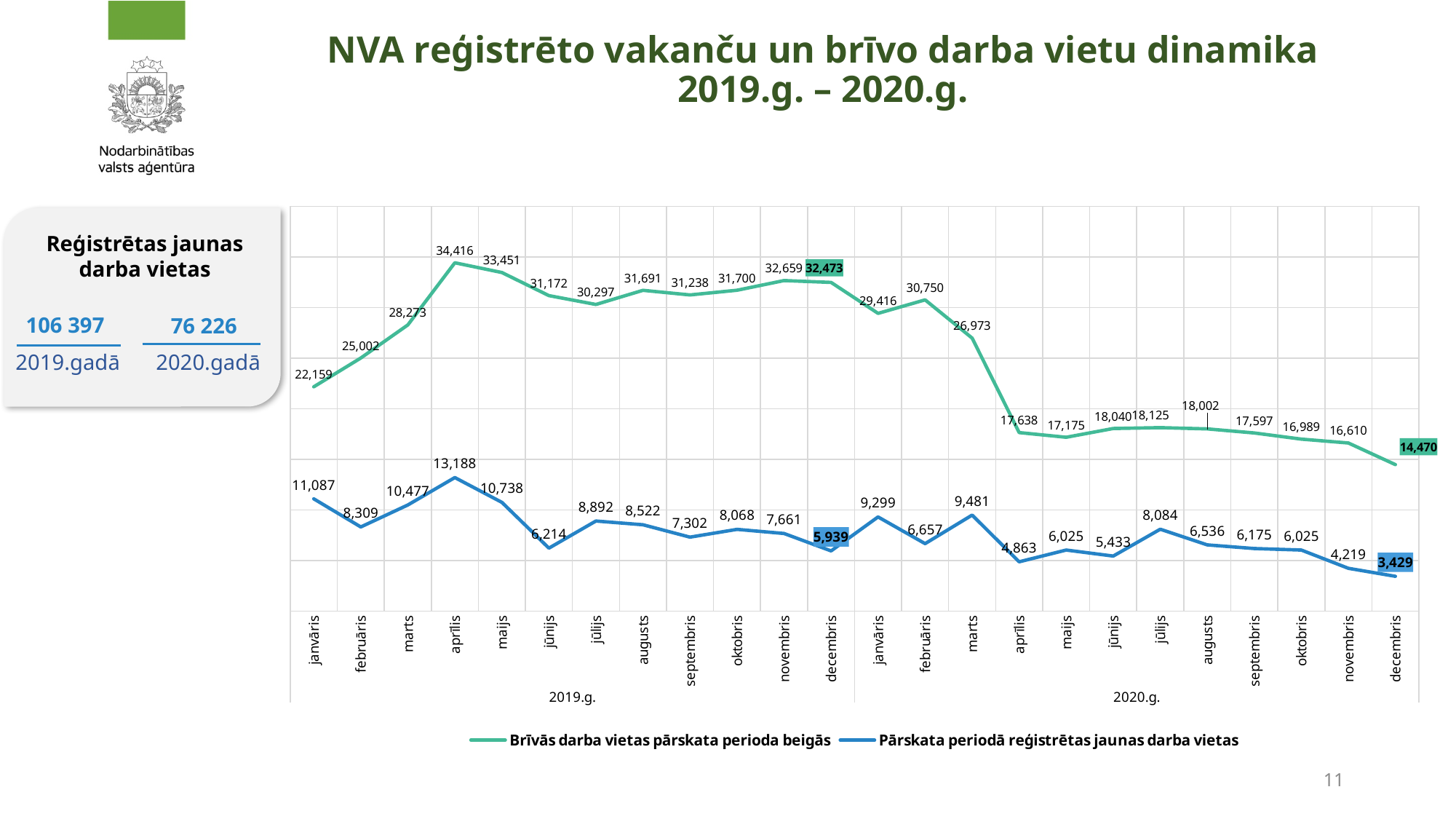
What type of chart is shown on the slide? Line chart Does 'Brīvās darba vietas pārskata perioda beigās' rise or fall from marts 2020 to decembris 2020? Fall What is the value of 'Brīvās darba vietas pārskata perioda beigās' for aprīlis 2019? 34,416 What is the value of 'Pārskata periodā reģistrētas jaunas darba vietas' for decembris 2020? 3,429 How many months are plotted on the x axis in total? 24 In which month and year does 'Brīvās darba vietas pārskata perioda beigās' reach its highest value? aprīlis 2019 What is the difference between the two series in aprīlis 2019? 21,228 Which is larger: 'Pārskata periodā reģistrētas jaunas darba vietas' in marts 2020 or in jūlijs 2020? marts 2020 What is the difference between 'Brīvās darba vietas pārskata perioda beigās' in decembris 2019 and decembris 2020? 18,003 What is the value of 'Brīvās darba vietas pārskata perioda beigās' for decembris 2019? 32,473 How many series does the legend list? 2 In which month and year does 'Pārskata periodā reģistrētas jaunas darba vietas' reach its lowest value? decembris 2020